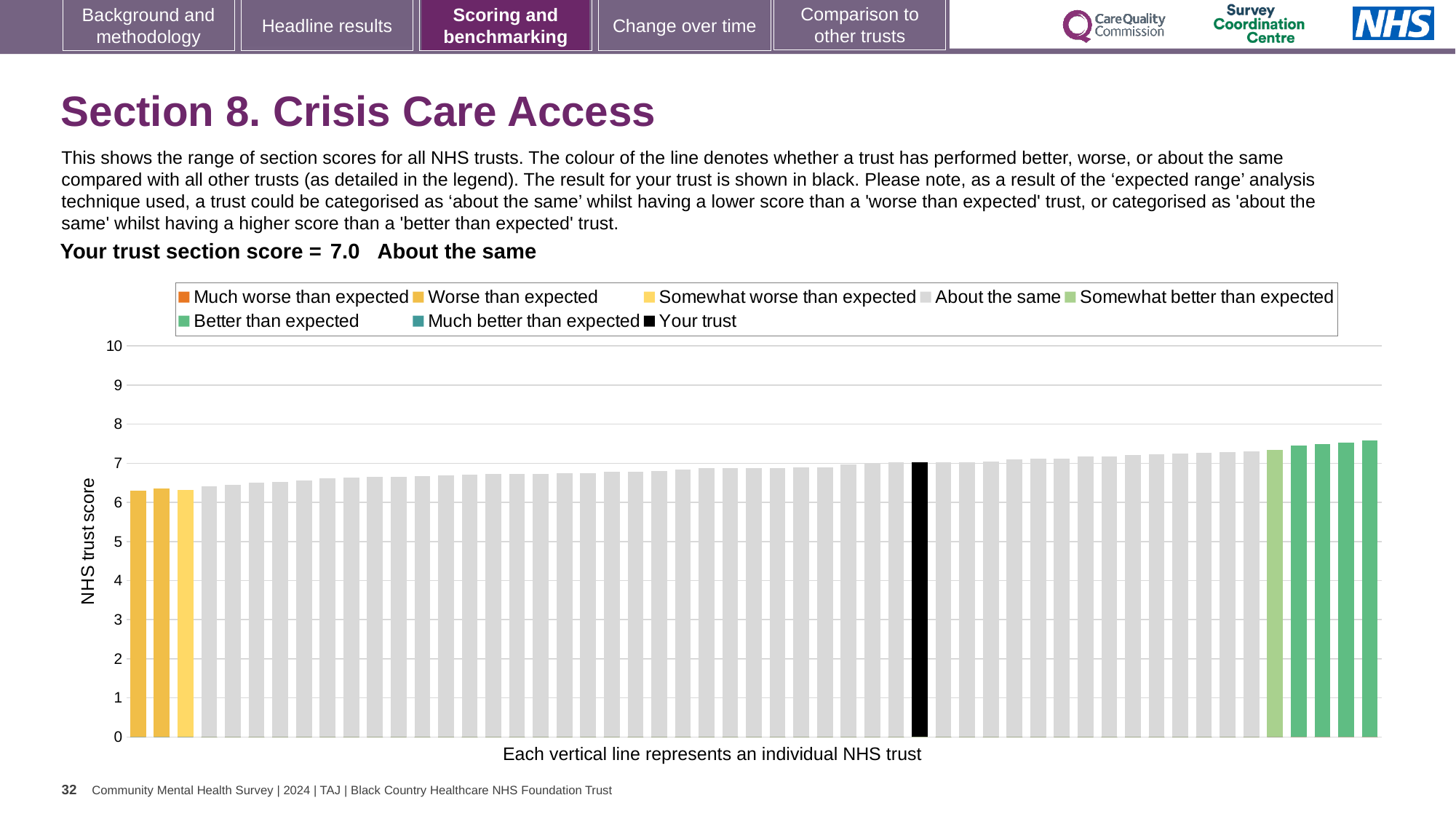
Is the value for the black 'Your trust' bar greater or less than 5? greater What does the black bar in the chart represent? Your trust How many bars are coloured as 'Worse than expected' (yellow) in the chart? 2 Which category is your trust placed in for this section? About the same Is the black 'Your trust' bar higher or lower than the rightmost bar in the chart? lower What kind of chart is shown on the slide? bar chart How many entries does the chart legend list? 8 Is the value of the shortest bar in the chart greater or less than 6? greater What is the label on the vertical axis of the chart? NHS trust score What is the section score for your trust shown on the slide? 7.0 Is the value of the tallest bar in the chart greater or less than 8? less Do the bar values rise or fall from left to right along the x axis? rise